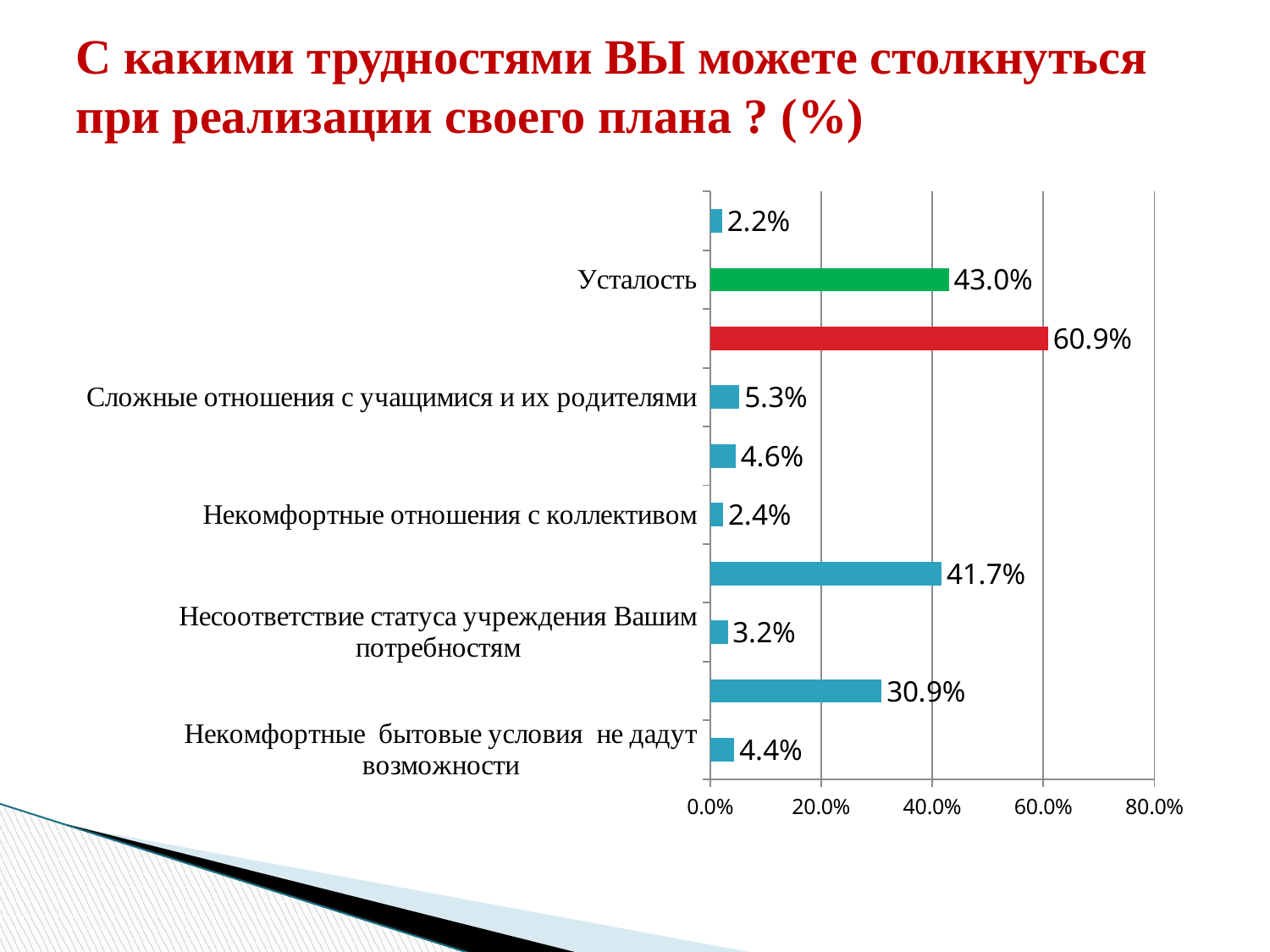
What type of chart is shown on the slide? bar chart What is the value for Усталость? 43.0% What is the value for Некомфортные бытовые условия не дадут возможности? 4.4% Is the value for Усталость greater or less than 40.0%? greater What is the lowest value shown on the chart? 2.2% What is the value for Несоответствие статуса учреждения Вашим потребностям? 3.2% What is the value for Некомфортные отношения с коллективом? 2.4% What is the value for Сложные отношения с учащимися и их родителями? 5.3% What is the highest value shown on the chart? 60.9% Which is larger, the value for Усталость or the value for Некомфортные бытовые условия не дадут возможности? Усталость What is the difference between the values for Усталость and Сложные отношения с учащимися и их родителями? 37.7% How many bars are plotted on the chart? 10